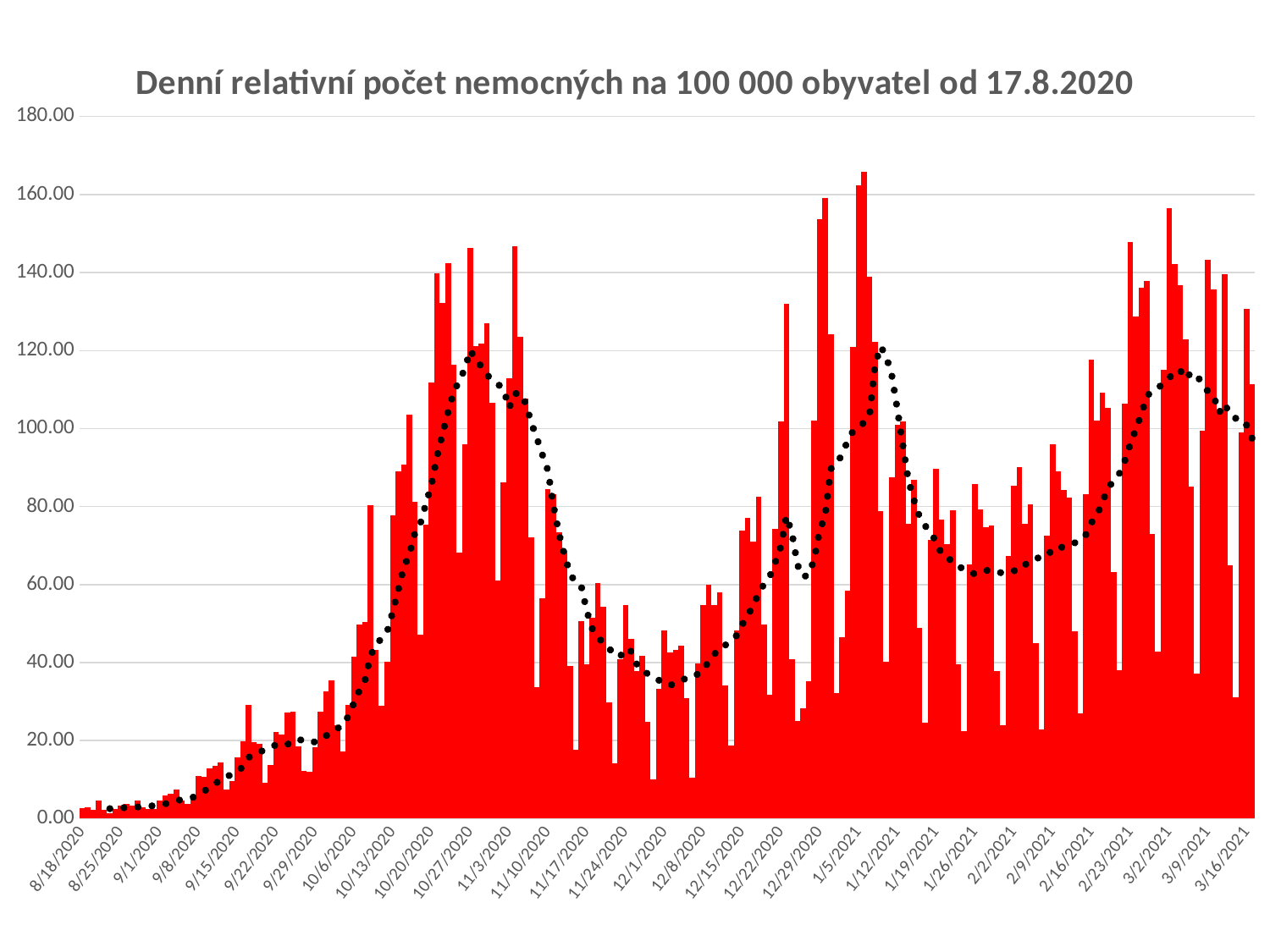
What kind of chart is shown on the slide? bar chart What is the highest value shown on the y axis of the chart? 180.00 Is the value for 8/18/2020 greater or less than 20? less How many date labels are shown on the x axis of the chart? 31 Do the values generally rise or fall between 10/27/2020 and 12/1/2020? fall Do the values generally rise or fall between 8/18/2020 and 10/27/2020? rise Which is higher: the dotted trend line around 1/12/2021 or around 1/26/2021? 1/12/2021 Do the values generally rise or fall between 12/1/2020 and 1/5/2021? rise What is the title of the chart? Denní relativní počet nemocných na 100 000 obyvatel od 17.8.2020 Is the highest bar in the chart greater or less than 140? greater Is the dotted trend line around 12/1/2020 greater or less than 60? less